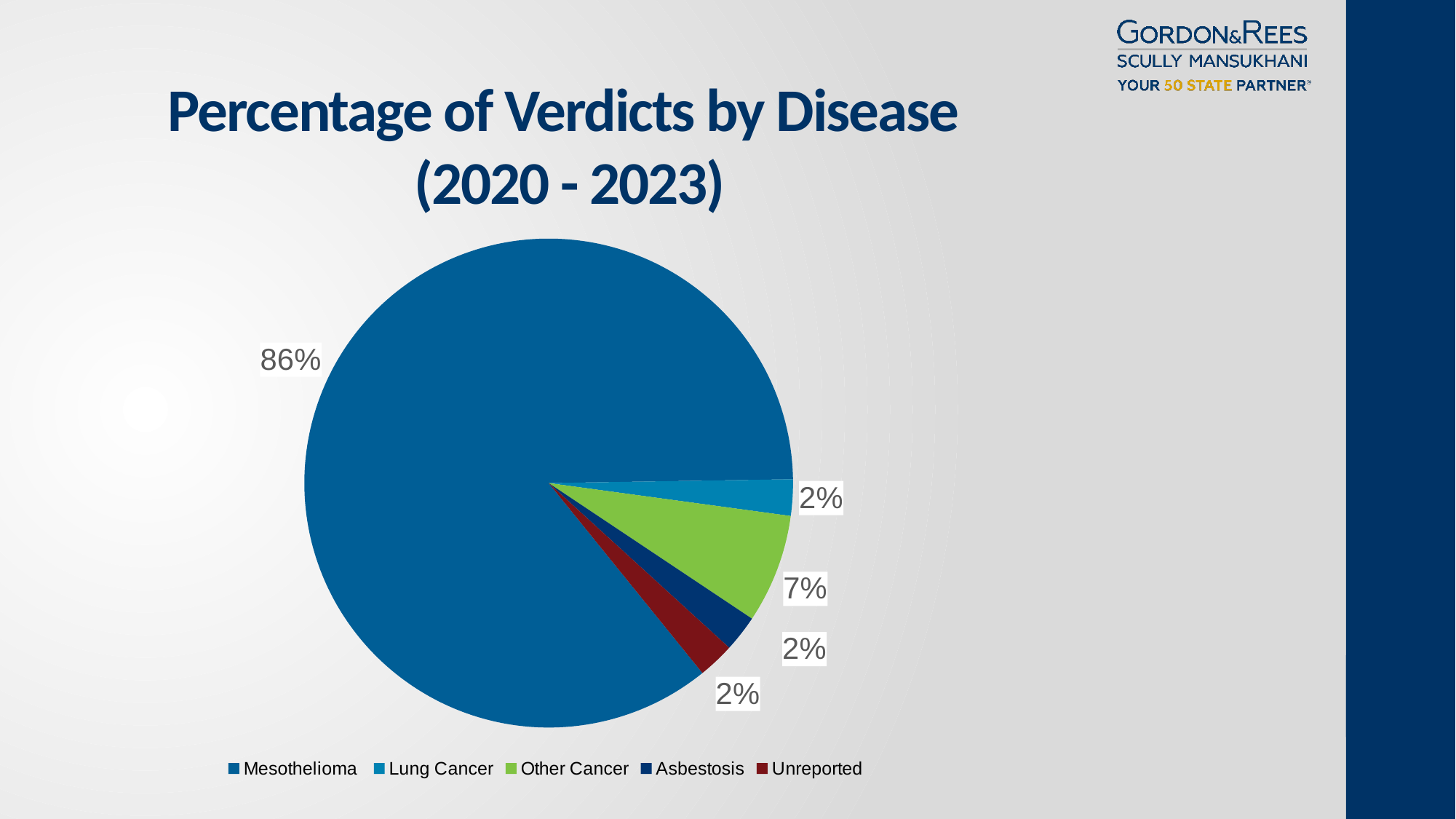
What percentage of verdicts is attributed to Lung Cancer? 2% What percentage of verdicts is attributed to Mesothelioma? 86% What is the title of the chart? Percentage of Verdicts by Disease (2020 - 2023) Which has a larger share of verdicts, Other Cancer or Lung Cancer? Other Cancer What colour is the Unreported slice in the pie chart? dark red What type of chart is shown on the slide? pie chart How many categories does the legend list? 5 What percentage of verdicts is attributed to Asbestosis? 2% What is the difference in percentage points between Mesothelioma and Other Cancer? 79 What percentage of verdicts is attributed to Unreported? 2% What percentage of verdicts is attributed to Other Cancer? 7% Which disease category has the largest share of verdicts? Mesothelioma